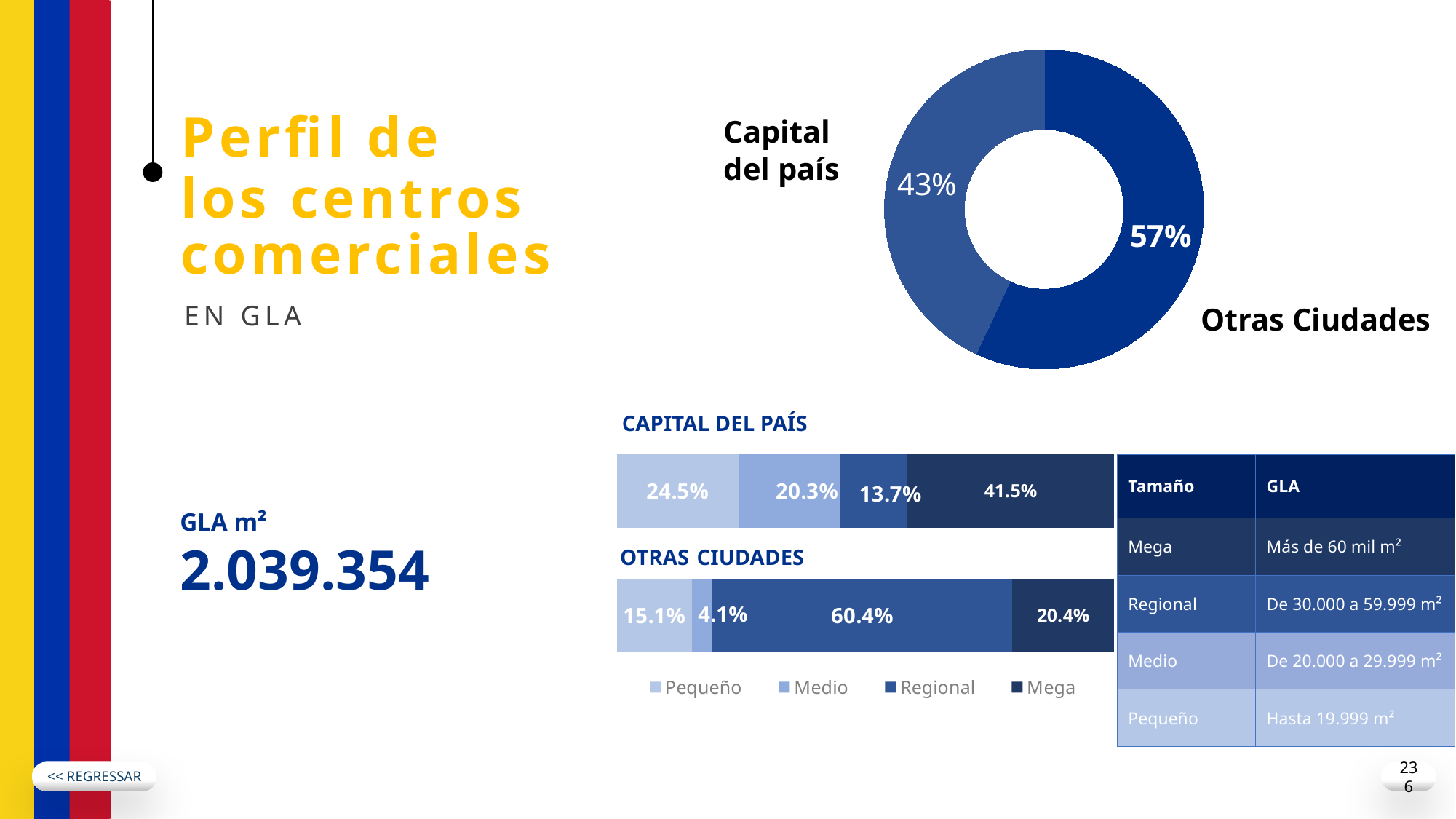
In the stacked bar chart titled OTRAS CIUDADES, what is the difference between the Regional and Mega values? 40 percentage points In the donut chart at the top, which segment is larger, Capital del país or Otras Ciudades? Otras Ciudades Which is larger: the Pequeño value in the CAPITAL DEL PAÍS bar or the Pequeño value in the OTRAS CIUDADES bar? CAPITAL DEL PAÍS In the stacked bar chart titled CAPITAL DEL PAÍS, what is the value for Mega? 41.5% In the stacked bar chart titled CAPITAL DEL PAÍS, which size category has the lowest value? Regional How many series does the legend below the stacked bar charts list? 4 What type of chart is used for the CAPITAL DEL PAÍS and OTRAS CIUDADES breakdowns? Stacked bar chart In the donut chart at the top, what share is labelled for Otras Ciudades? 57% In the stacked bar chart titled OTRAS CIUDADES, what is the value for Regional? 60.4% In the stacked bar chart titled OTRAS CIUDADES, which size category has the lowest value? Medio In the donut chart at the top, what share is labelled for Capital del país? 43% In the donut chart at the top, how many segments are there? 2